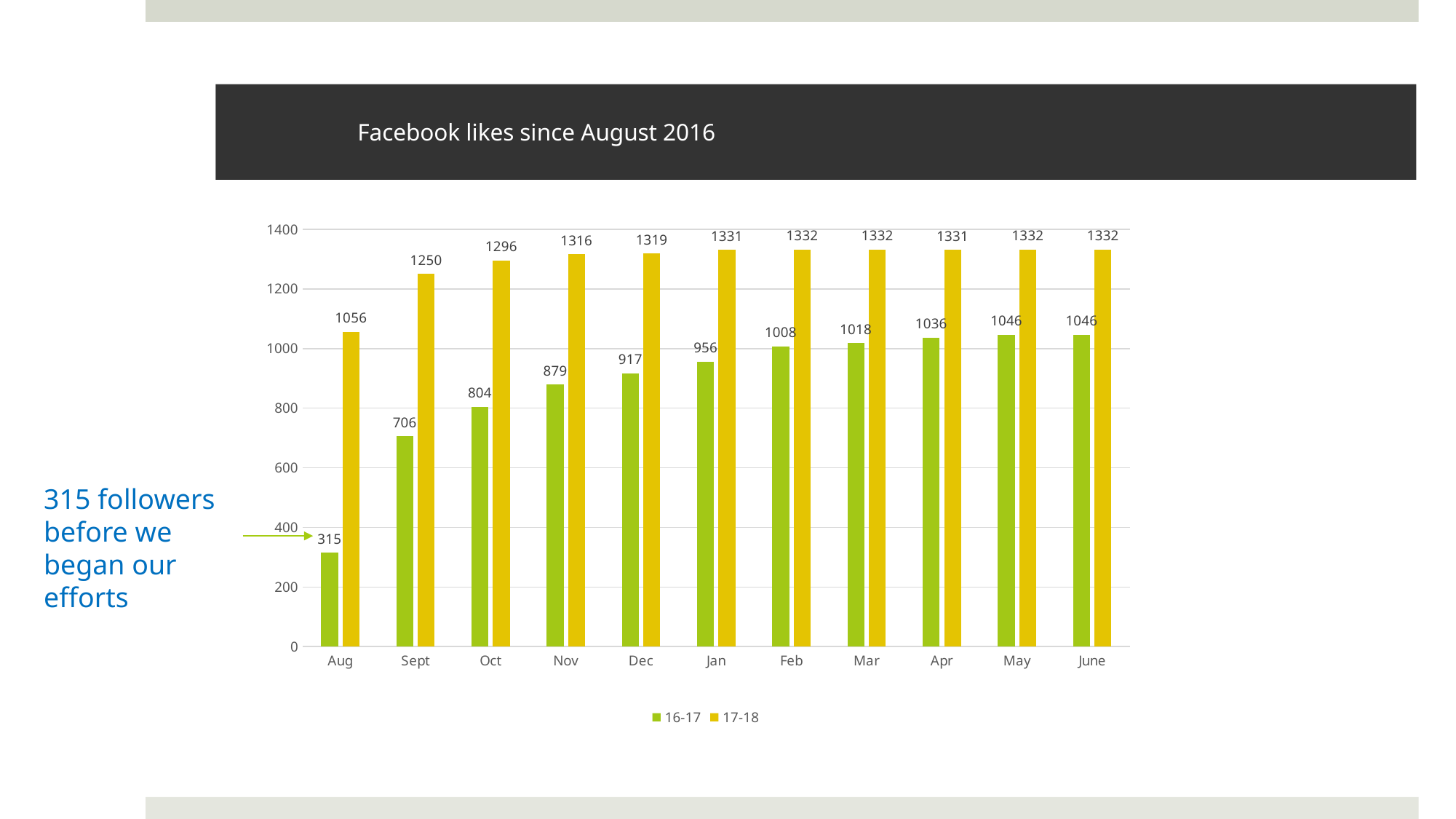
Is the value for 16-17 in Dec greater or less than 1000? less Which is larger in Nov, the 16-17 value or the 17-18 value? 17-18 What is the value for 17-18 in Oct? 1296 What is the value for 16-17 in Mar? 1018 What kind of chart is shown on the slide? bar chart Which month has the lowest value for the 16-17 series? Aug What is the value for 16-17 in Aug? 315 How many series does the legend list? 2 What is the difference between the 17-18 and 16-17 values in Sept? 544 Which month has the lowest value for the 17-18 series? Aug Do the 16-17 values generally rise or fall from Aug to June? rise How many months are shown on the x axis? 11